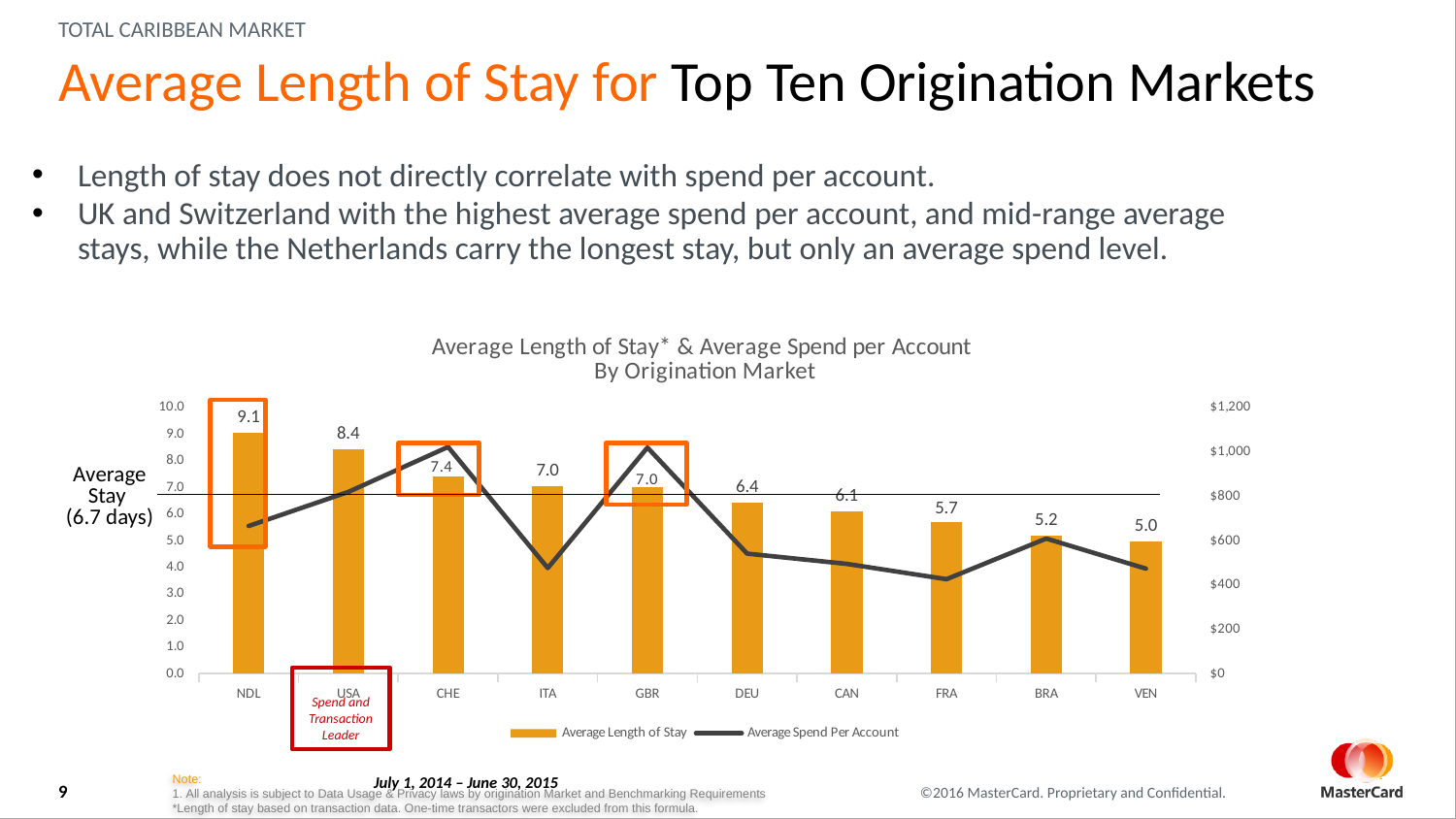
Is the Average Spend Per Account for FRA greater or less than $600? less How many origination markets are shown on the x axis? 10 What is the Average Length of Stay for USA? 8.4 Is the Average Spend Per Account for CHE greater or less than $800? greater Which has a longer Average Length of Stay, CHE or CAN? CHE Which origination market has the lowest Average Length of Stay? VEN What is the Average Length of Stay for DEU? 6.4 What is the Average Length of Stay for NDL? 9.1 What is the difference in Average Length of Stay between NDL and VEN? 4.1 Which origination market has the highest Average Length of Stay? NDL How many series does the legend list? 2 What is the title of the chart? Average Length of Stay* & Average Spend per Account By Origination Market